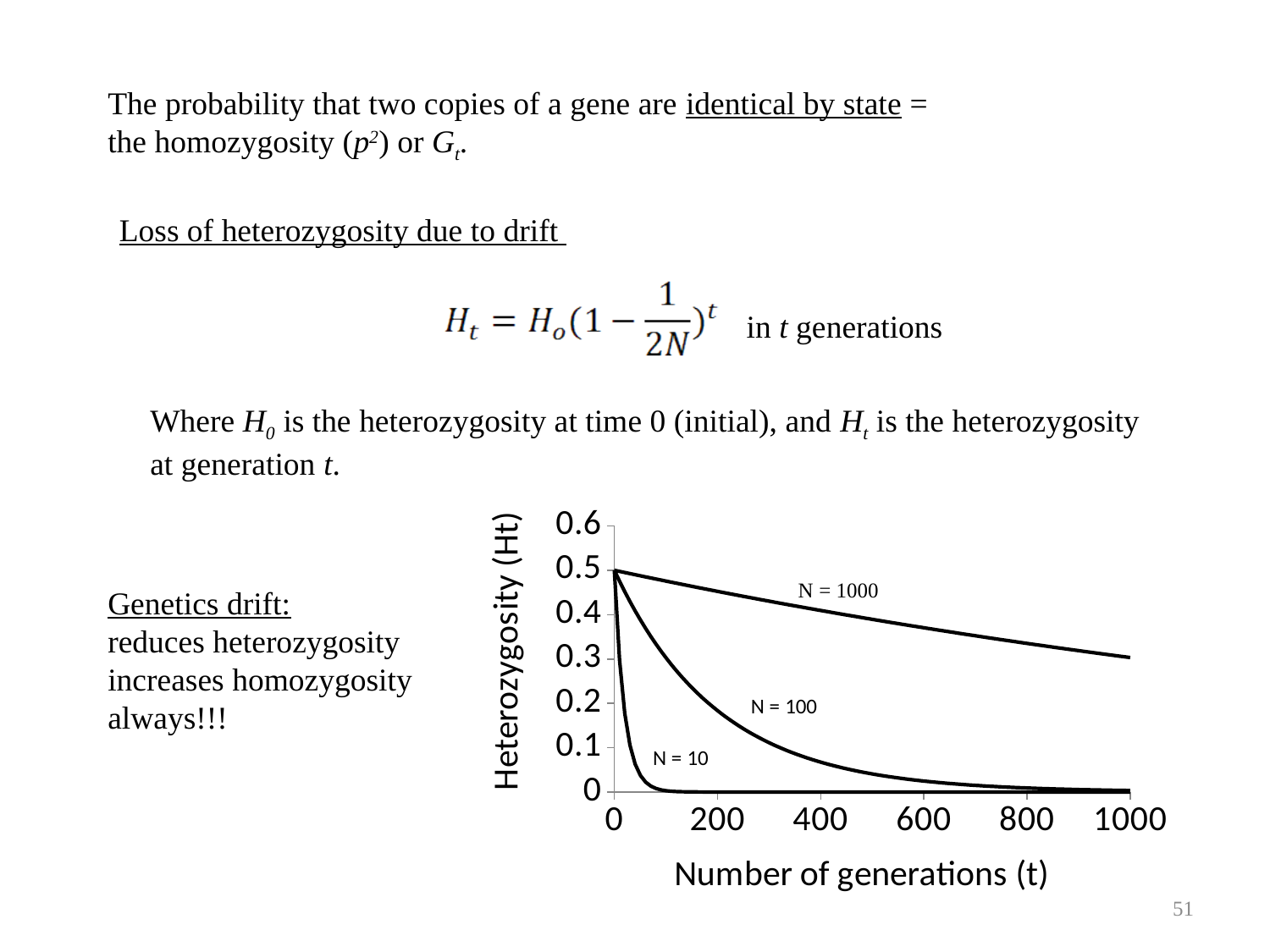
Which curve has the highest heterozygosity at 1000 generations? N = 1000 How many curves (population sizes) are plotted on the chart? 3 What is the heterozygosity value at generation 0 for all three curves? 0.5 Is the heterozygosity for N = 100 at 400 generations greater or less than 0.1? less What is the title of the y axis of the chart? Heterozygosity (Ht) Is the heterozygosity for N = 1000 at 200 generations greater or less than 0.4? greater Do the heterozygosity values rise or fall as the number of generations increases? fall What is the title of the x axis of the chart? Number of generations (t) At 400 generations, which curve has the larger heterozygosity, N = 1000 or N = 100? N = 1000 What kind of chart is shown on the slide? line chart Which curve drops to near zero heterozygosity fastest? N = 10 Is the heterozygosity for N = 10 at 200 generations greater or less than 0.1? less